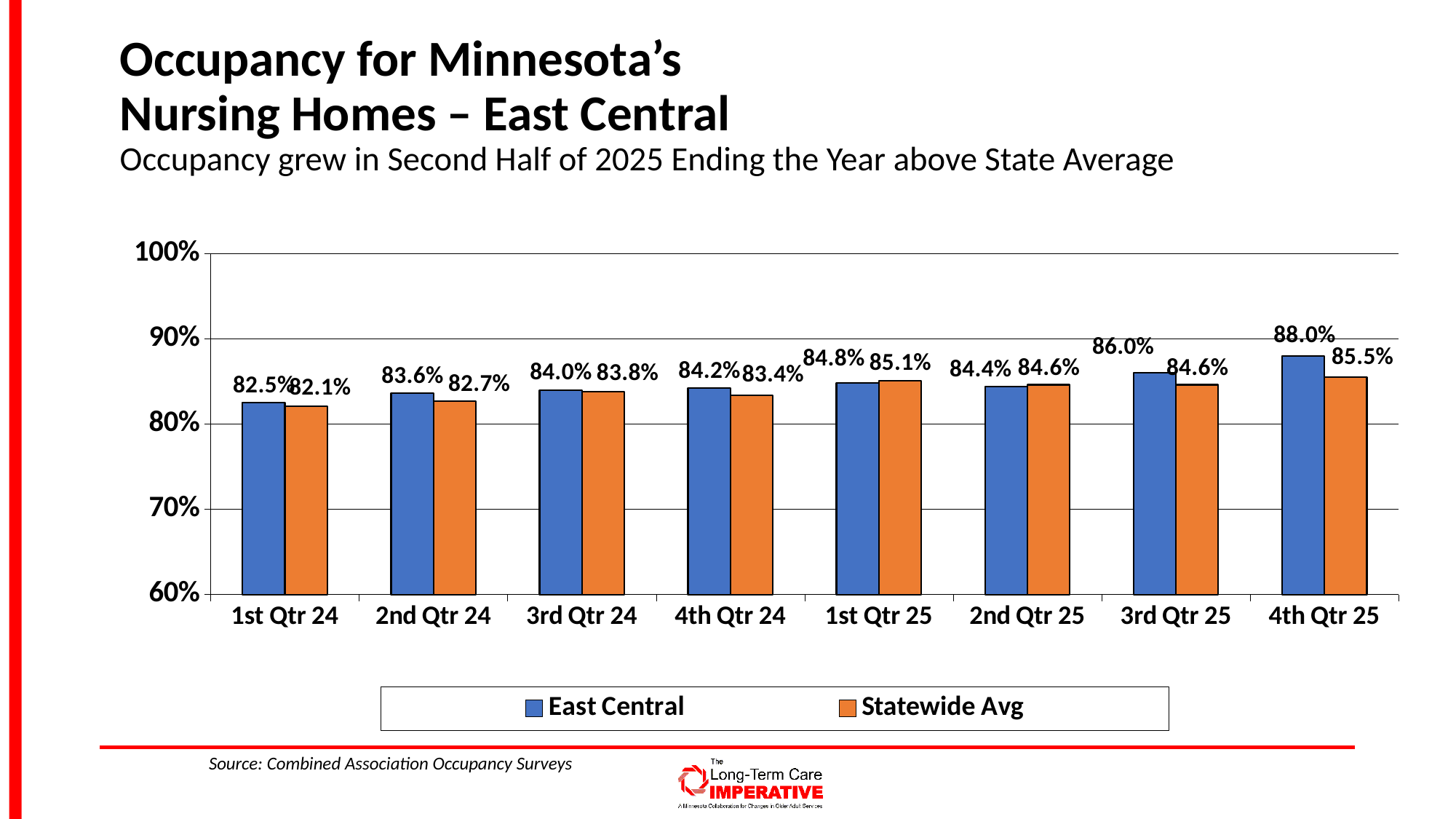
How many series does the legend list? 2 What is the difference between the East Central and Statewide Avg values in 4th Qtr 25? 2.5% What is the East Central occupancy value for 4th Qtr 25? 88.0% What is the Statewide Avg occupancy value for 1st Qtr 24? 82.1% What is the East Central occupancy value for 3rd Qtr 25? 86.0% Which is larger in 1st Qtr 25, East Central or Statewide Avg? Statewide Avg How many quarters are shown on the x axis? 8 In which quarter is the East Central occupancy highest? 4th Qtr 25 What kind of chart is shown on the slide? Bar chart What is the Statewide Avg occupancy value for 4th Qtr 24? 83.4% In which quarter is the Statewide Avg occupancy lowest? 1st Qtr 24 Which colour represents the Statewide Avg series? Orange